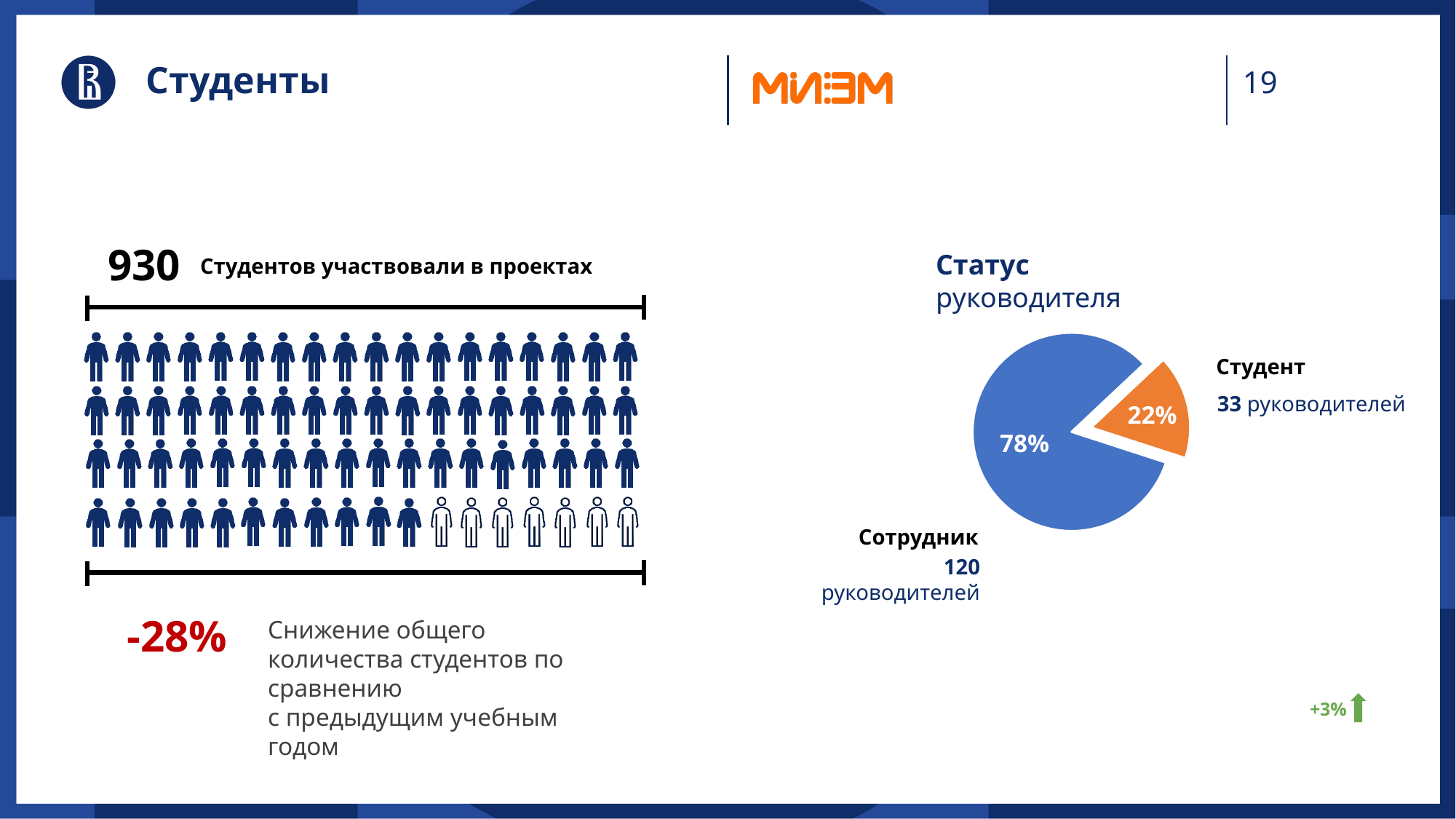
In the "Статус руководителя" pie chart, what is the difference in percentage points between the "Сотрудник" and "Студент" slices? 56 In the "Статус руководителя" pie chart, how many руководителей are labelled for "Студент"? 33 How many slices does the "Статус руководителя" pie chart have? 2 In the "Статус руководителя" pie chart, which category has the smallest slice? Студент In the "Статус руководителя" pie chart, how many руководителей are labelled for "Сотрудник"? 120 In the "Статус руководителя" pie chart, what share of the pie does "Студент" take? 22% In the "Статус руководителя" pie chart, what is the difference between the number of руководителей for "Сотрудник" and for "Студент"? 87 In the "Статус руководителя" pie chart, which is larger: the "Студент" slice or the "Сотрудник" slice? Сотрудник In the "Статус руководителя" pie chart, which category has the largest slice? Сотрудник In the "Статус руководителя" pie chart, what colour is the "Студент" slice? orange What kind of chart is shown under the title "Статус руководителя"? pie chart In the "Статус руководителя" pie chart, what share of the pie does "Сотрудник" take? 78%